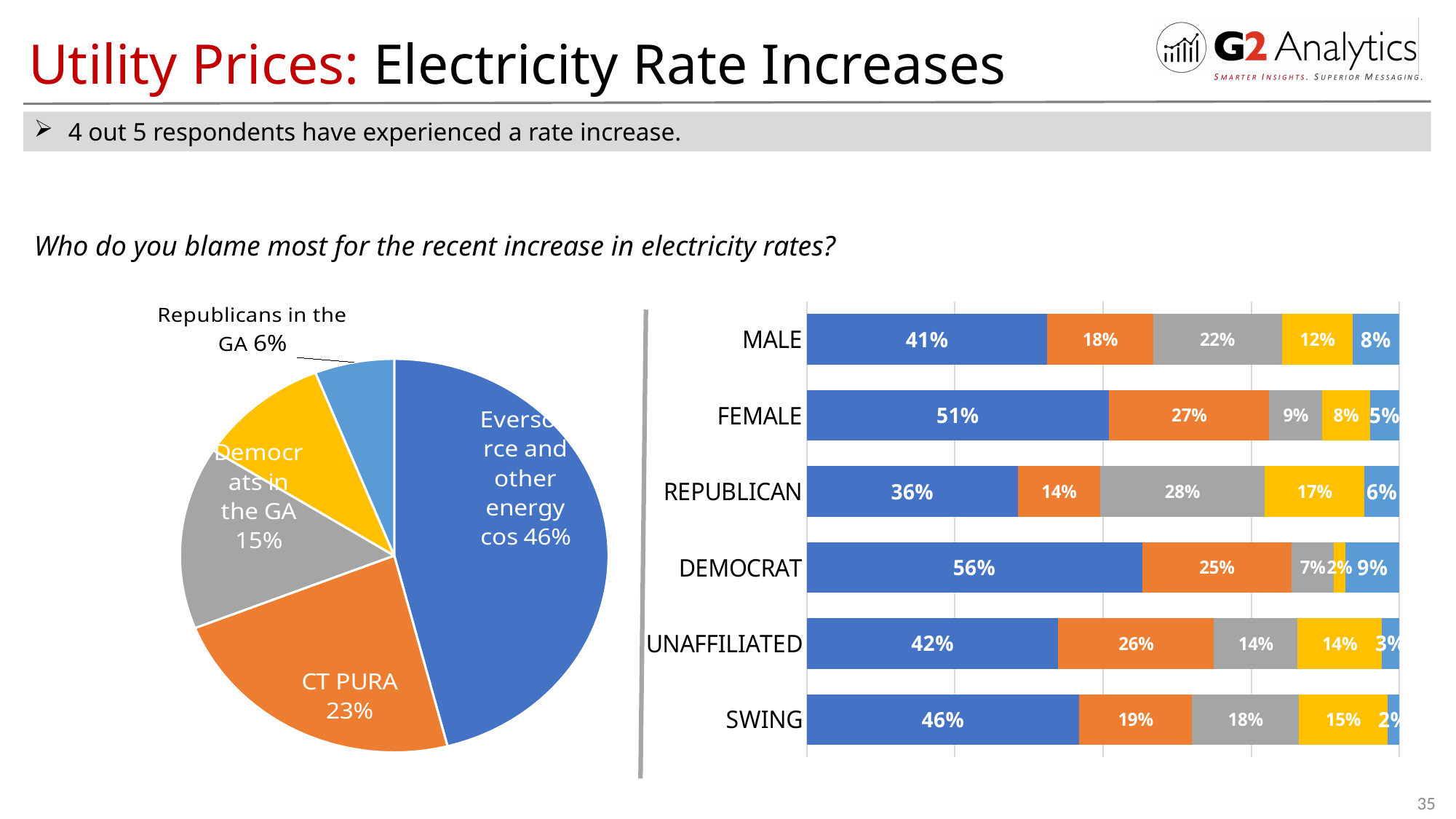
On the pie chart on the left, what share of respondents blame CT PURA? 23% On the pie chart on the left, what share of respondents blame Democrats in the GA? 15% On the pie chart on the left, which labeled slice is the largest? Eversource and other energy cos On the bar chart on the right, what is the value of the first (blue) segment for DEMOCRAT? 56% On the bar chart on the right, how many categories are shown on the vertical axis? 6 On the pie chart on the left, how many percentage points larger is the Eversource and other energy cos slice than the CT PURA slice? 23 What kind of chart is on the left side of the slide? Pie chart On the bar chart on the right, which category has the largest first (blue) segment? DEMOCRAT What kind of chart is on the right side of the slide? Stacked bar chart On the pie chart on the left, which labeled slice is the smallest? Republicans in the GA On the bar chart on the right, which is larger: the grey segment for REPUBLICAN or the grey segment for MALE? REPUBLICAN On the bar chart on the right, what is the value of the orange segment for FEMALE? 27%